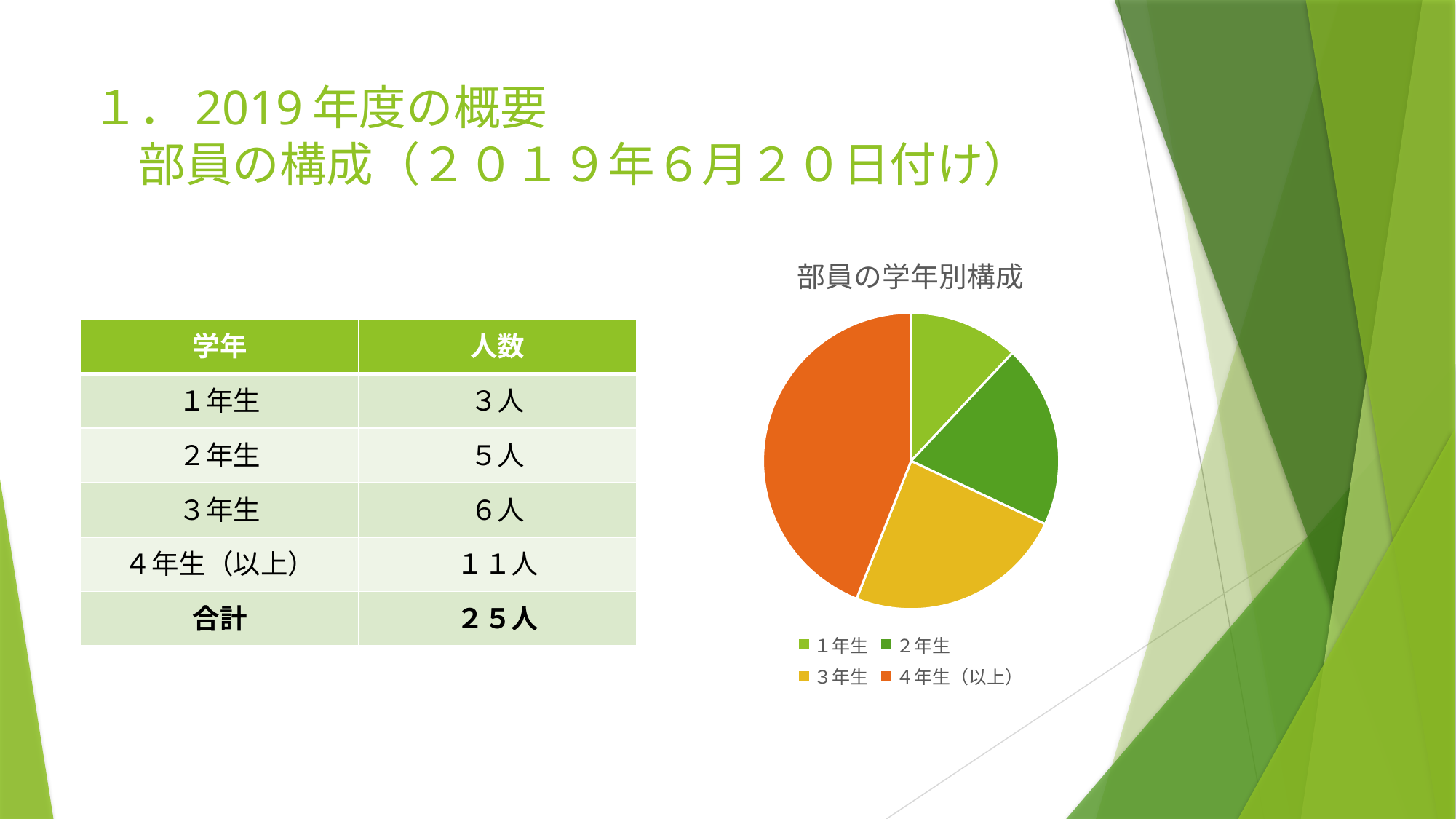
Which category has the largest slice in the pie chart? 4年生（以上） How many slices does the pie chart have? 4 What kind of chart is shown on the slide? pie chart What is the title of the pie chart? 部員の学年別構成 Which slice is larger in the pie chart, 2年生 or 3年生? 3年生 Which category has the smallest slice in the pie chart? 1年生 According to the slide, how many members are 4年生（以上）? １１人 According to the slide, how many members are 1年生? 3人 What is the total number of members shown on the slide? ２５人 What share of the pie chart does 4年生（以上） represent? 44% What is the difference in members between 4年生（以上） and 3年生? 5人 How many entries does the pie chart's legend list? 4